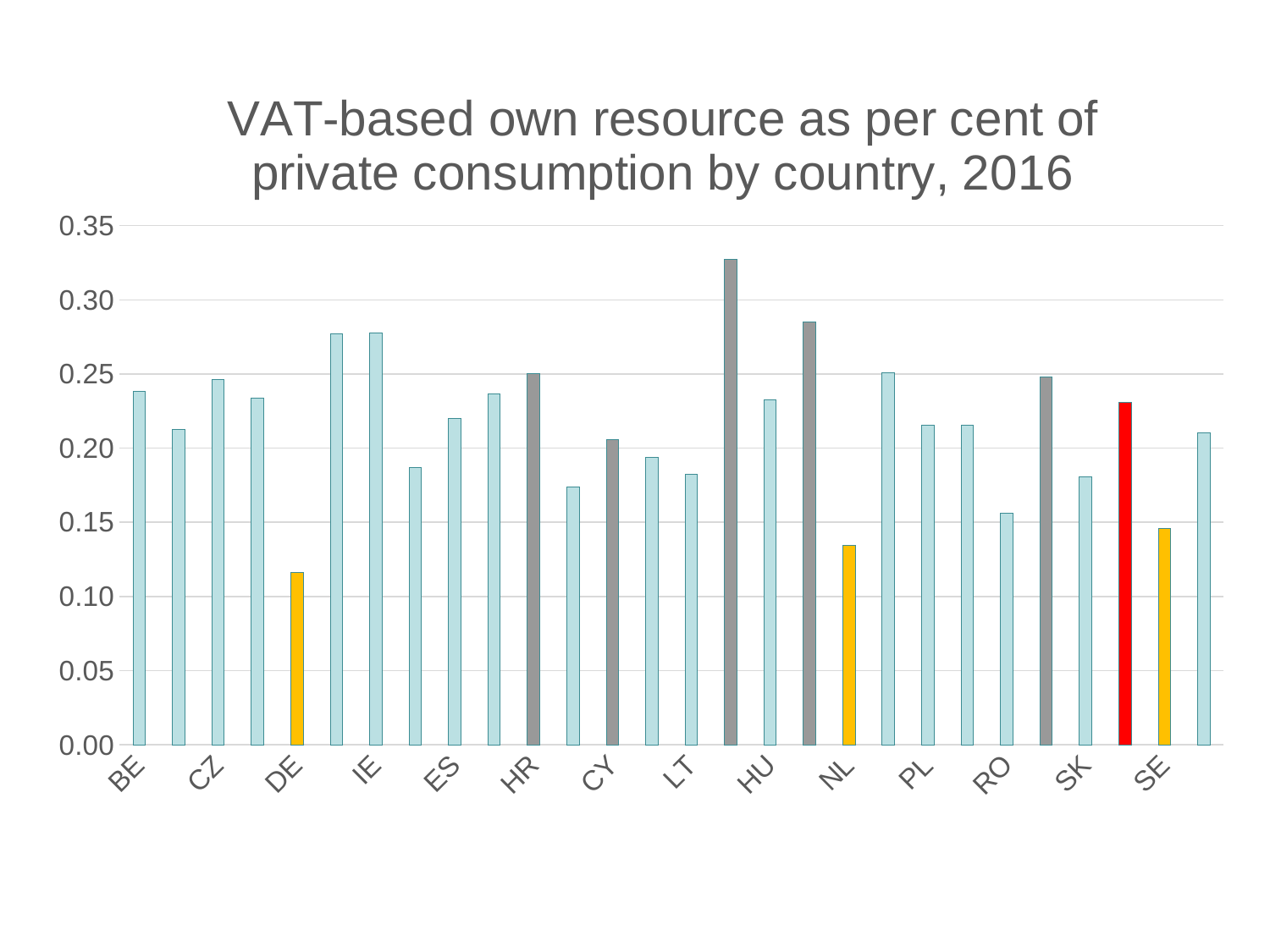
How many country labels are shown on the x axis? 14 What kind of chart is shown on the slide? bar chart What is the title of the chart? VAT-based own resource as per cent of private consumption by country, 2016 Is the value for RO greater or less than 0.20? less Which labelled country has the lowest bar in the chart? DE Is the value for SK greater or less than 0.20? less Is the value for ES greater or less than 0.20? greater Which has the larger value, HR or CY? HR Which has the larger value, IE or DE? IE